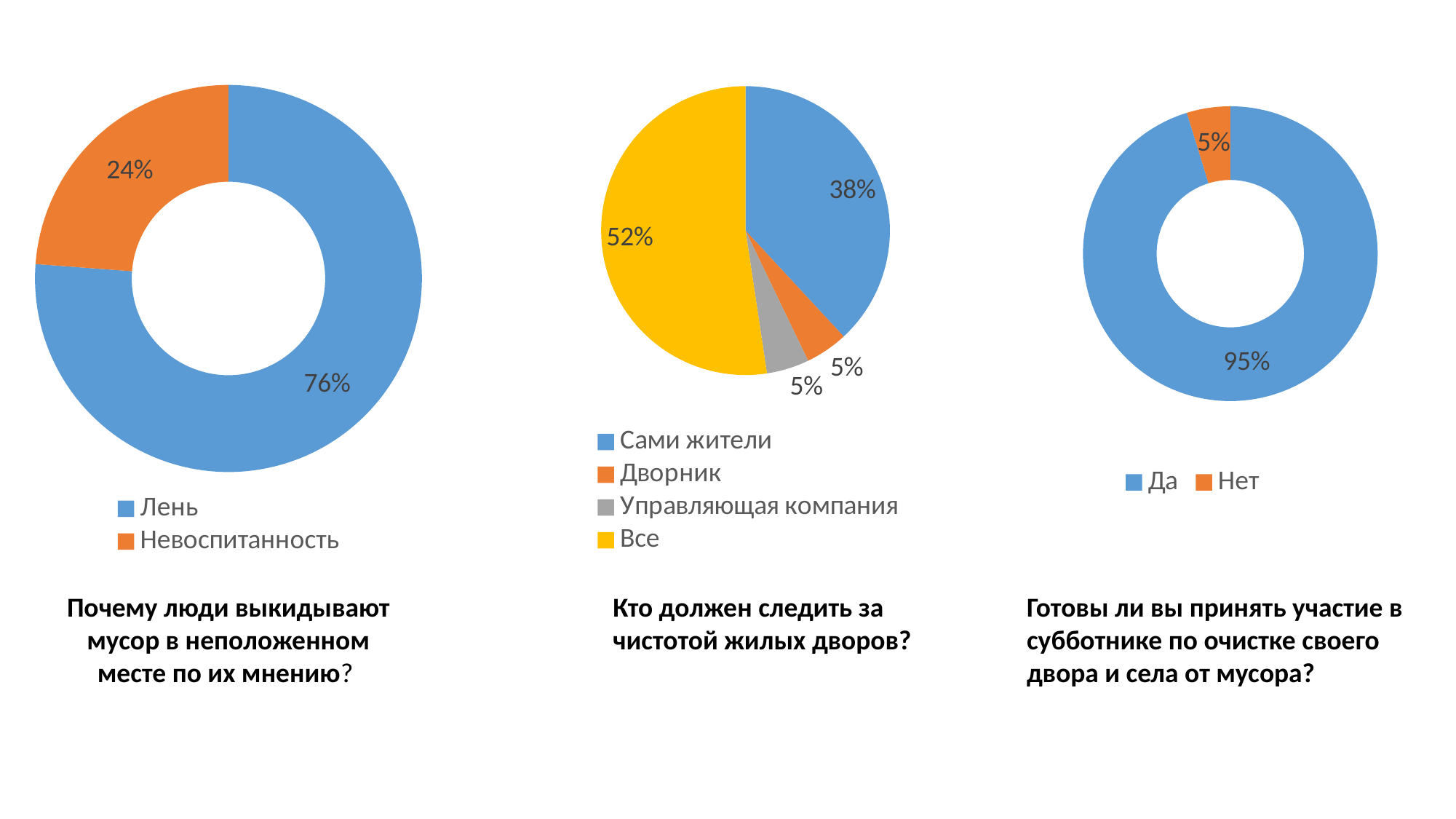
In the right chart (Готовы ли вы принять участие в субботнике по очистке своего двора и села от мусора?), what share is labelled for Да? 95% In the middle chart (Кто должен следить за чистотой жилых дворов?), what share is labelled for Все? 52% What kind of chart is the middle chart (Кто должен следить за чистотой жилых дворов?)? Pie chart In the left chart (Почему люди выкидывают мусор в неположенном месте по их мнению?), what is the difference between the Лень and Невоспитанность shares? 52% In the middle chart (Кто должен следить за чистотой жилых дворов?), what share is labelled for Сами жители? 38% In the left chart (Почему люди выкидывают мусор в неположенном месте по их мнению?), what colour is the Невоспитанность segment? Orange In the middle chart (Кто должен следить за чистотой жилых дворов?), how many categories does the legend list? 4 In the left chart (Почему люди выкидывают мусор в неположенном месте по их мнению?), what share is labelled for Лень? 76% In the left chart (Почему люди выкидывают мусор в неположенном месте по их мнению?), what share is labelled for Невоспитанность? 24% In the middle chart (Кто должен следить за чистотой жилых дворов?), which category has the largest share? Все In the right chart (Готовы ли вы принять участие в субботнике по очистке своего двора и села от мусора?), what share is labelled for Нет? 5% In the middle chart (Кто должен следить за чистотой жилых дворов?), which is larger: Сами жители or Дворник? Сами жители